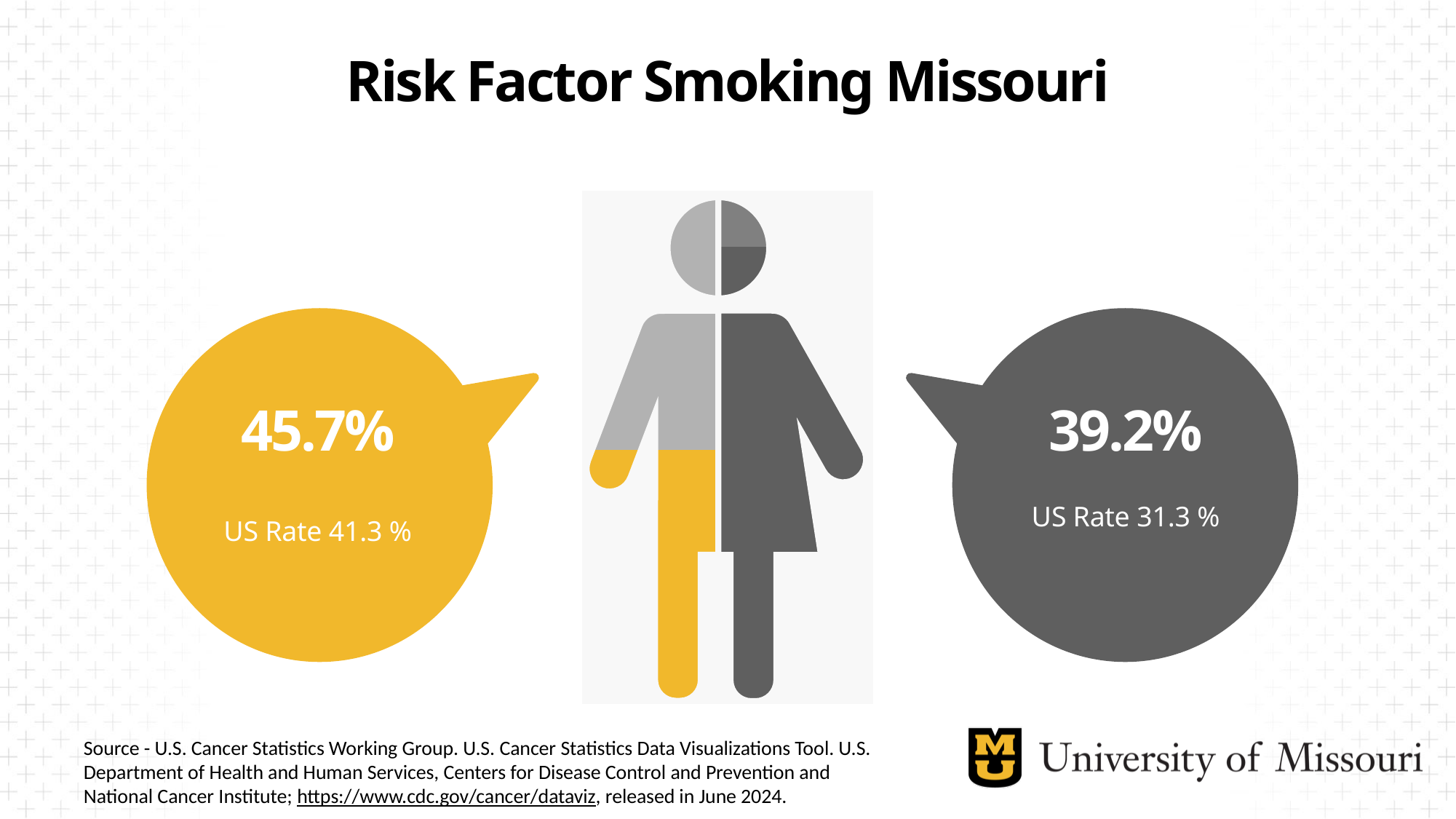
What value is shown in the grey speech bubble on the right? 39.2% What value is shown in the yellow speech bubble on the left? 45.7% Is the Missouri value in the grey bubble greater or less than its US rate? greater What is the title of the slide? Risk Factor Smoking Missouri What US rate is shown in the yellow speech bubble on the left? 41.3 % By how much does the Missouri value in the yellow bubble (45.7%) exceed its US rate (41.3 %)? 4.4% What US rate is shown in the grey speech bubble on the right? 31.3 % Which speech bubble shows the higher Missouri value, the yellow one on the left or the grey one on the right? the yellow one on the left What kind of visual is used on this slide to present the data? an infographic with a person pictogram and two speech bubbles How many speech bubbles with values are shown on the slide? 2 What is the difference between the Missouri value in the yellow bubble (45.7%) and the Missouri value in the grey bubble (39.2%)? 6.5% By how much does the Missouri value in the grey bubble (39.2%) exceed its US rate (31.3 %)? 7.9%